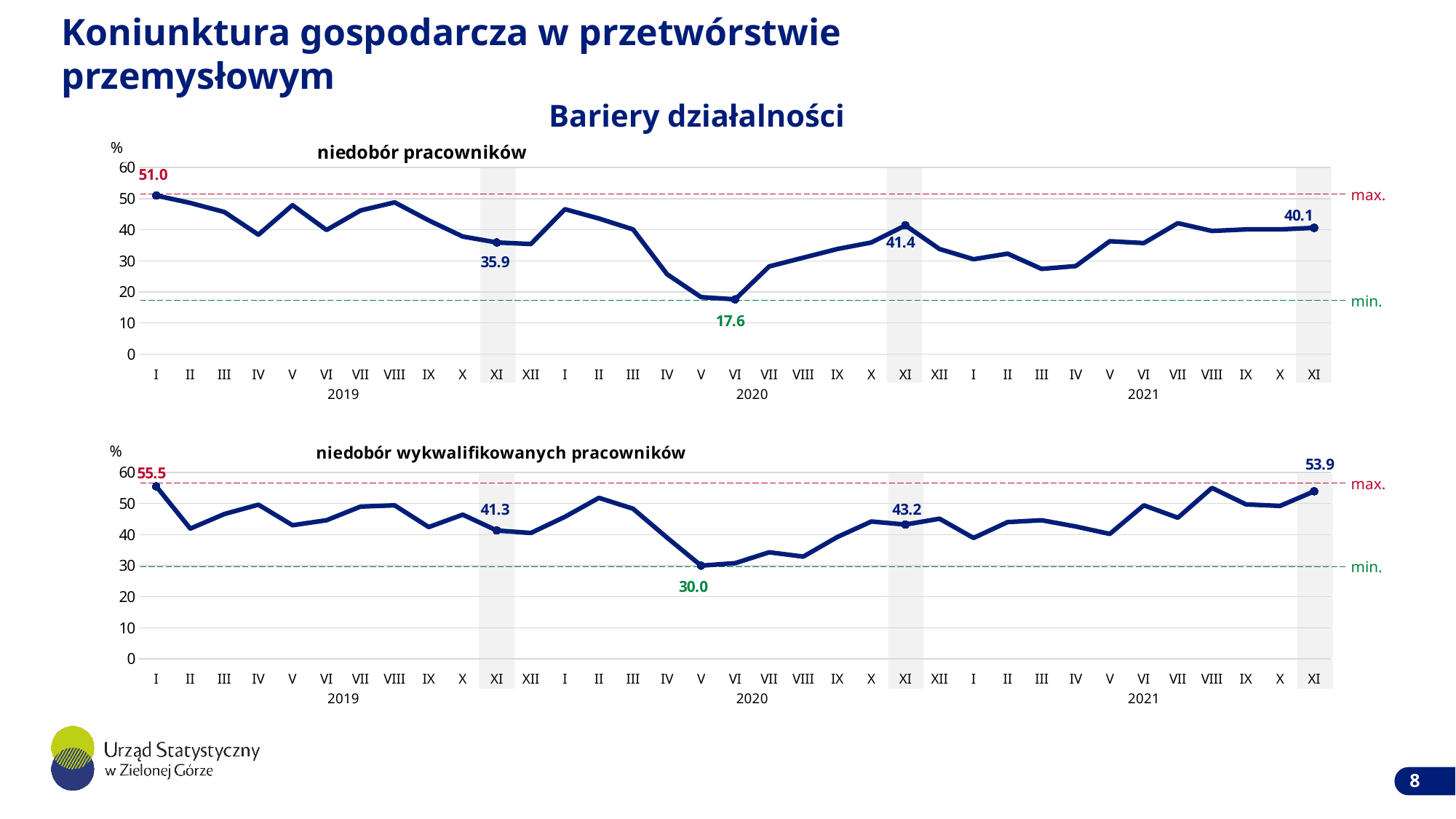
In the chart 'niedobór pracowników', is the value for V 2020 greater or less than 30? less In the chart 'niedobór wykwalifikowanych pracowników', what is the value for V 2020? 30.0 In the chart 'niedobór pracowników', which month has the lowest value? VI 2020 What kind of chart is 'niedobór pracowników'? line chart In the chart 'niedobór wykwalifikowanych pracowników', which is larger: the value for XI 2019 or XI 2020? XI 2020 In the chart 'niedobór pracowników', what is the value for I 2019? 51.0 In the chart 'niedobór wykwalifikowanych pracowników', which month has the highest value? I 2019 In the chart 'niedobór wykwalifikowanych pracowników', what is the value for XI 2021? 53.9 In the chart 'niedobór pracowników', what is the value for XI 2021? 40.1 In the chart 'niedobór wykwalifikowanych pracowników', what is the difference between the values for I 2019 and XI 2021? 1.6 In the chart 'niedobór wykwalifikowanych pracowników', is the value for VIII 2021 greater or less than 50? greater In the chart 'niedobór pracowników', what is the difference between the values for XI 2020 and XI 2019? 5.5